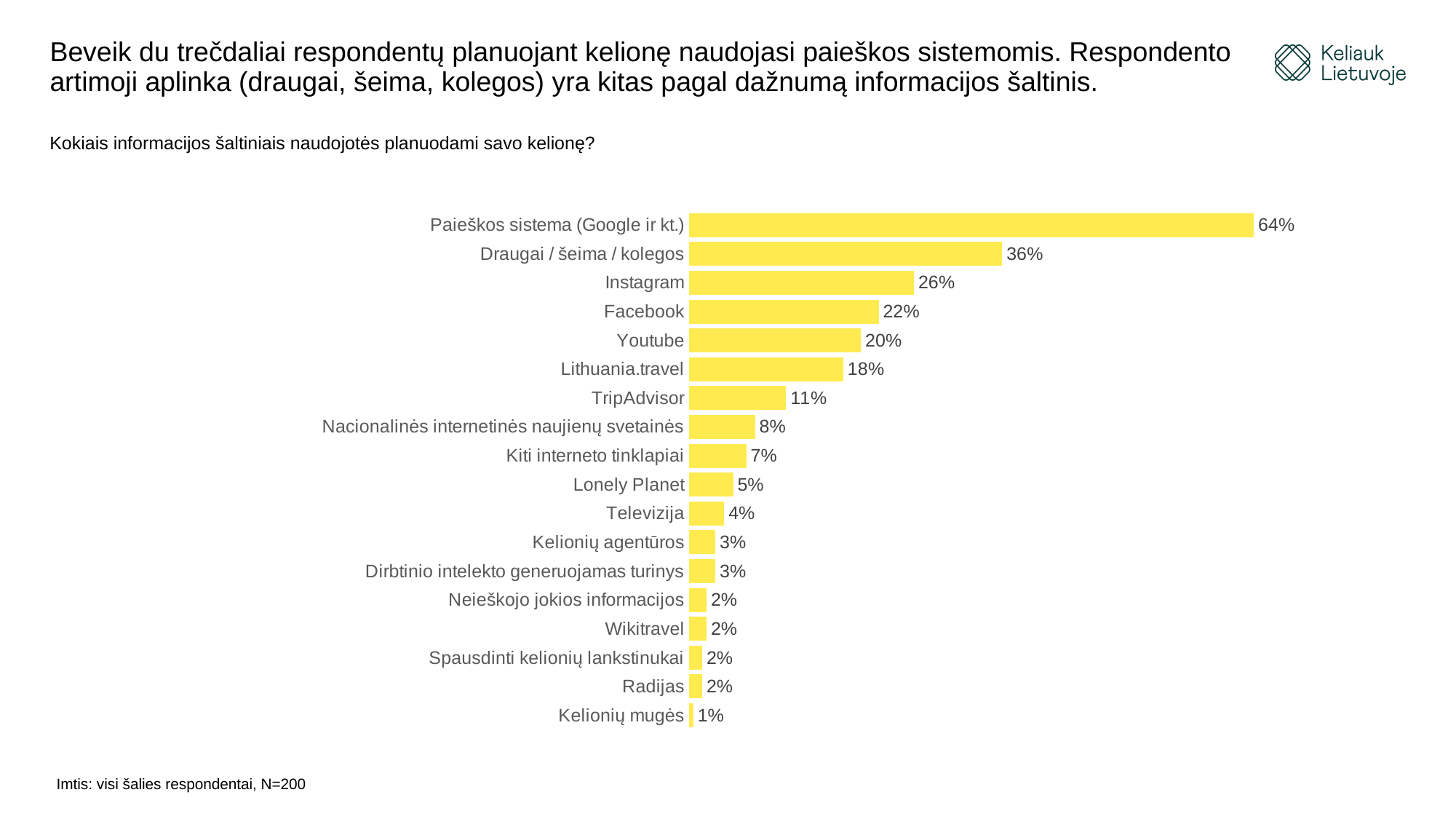
Which has a larger value, Instagram or Facebook? Instagram How many information sources (categories) are shown in the chart? 18 What kind of chart is shown on the slide? Bar chart Which information source has the lowest value? Kelionių mugės What percentage of respondents used Paieškos sistema (Google ir kt.) when planning their trip? 64% What is the value shown for Instagram? 26% Which information source has the highest value? Paieškos sistema (Google ir kt.) What is the difference between the values for Facebook and Youtube? 2% What is the difference between the values for Paieškos sistema (Google ir kt.) and Draugai / šeima / kolegos? 28% What is the value shown for TripAdvisor? 11% What colour are the bars in the chart? Yellow What is the value shown for Lithuania.travel? 18%